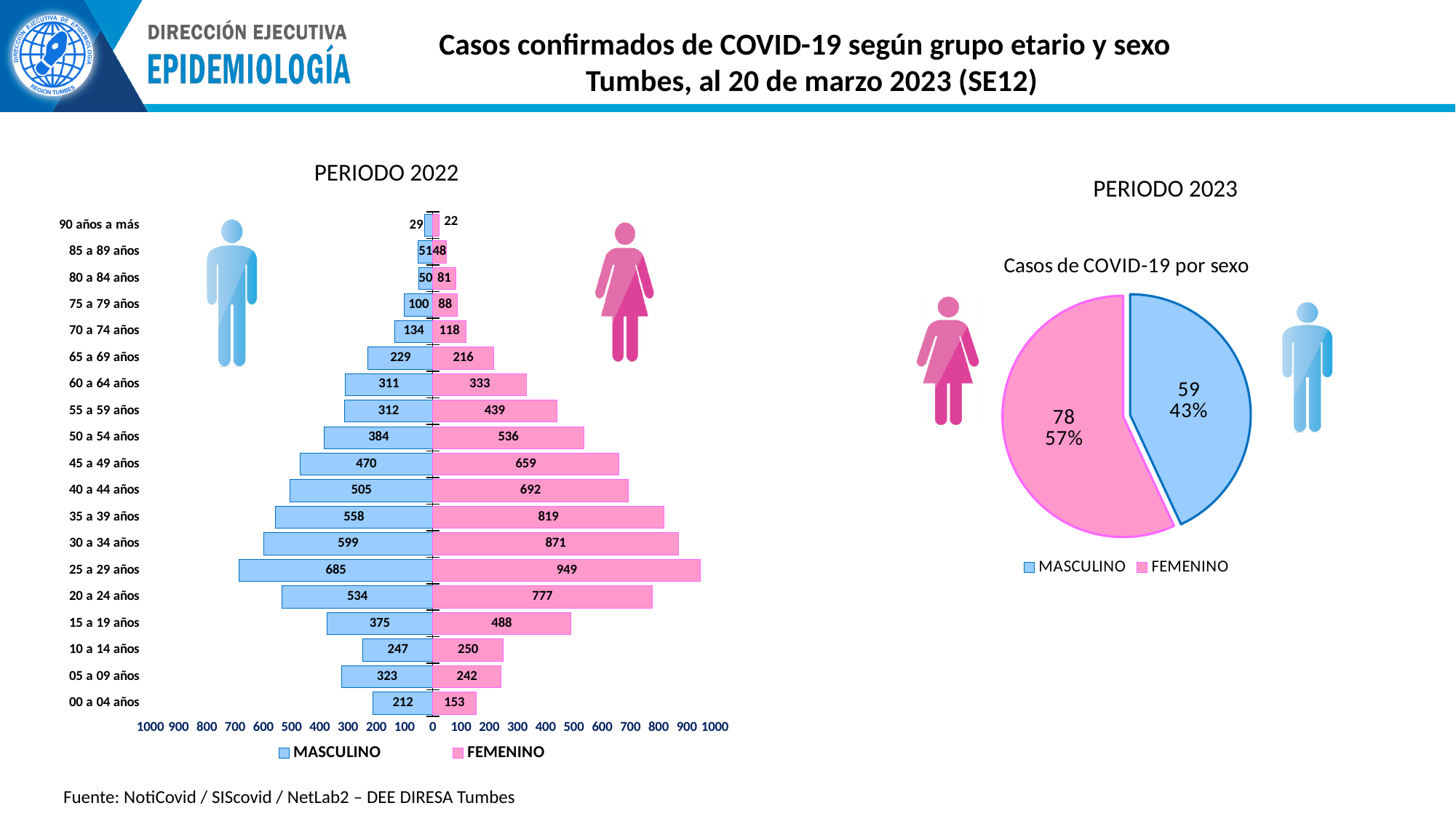
In the PERIODO 2023 pie chart, how many MASCULINO cases are shown? 59 How many age groups are shown in the PERIODO 2022 chart? 19 In the PERIODO 2022 chart, what is the difference between FEMENINO and MASCULINO cases in the 35 a 39 años group? 261 In the PERIODO 2022 chart, how many MASCULINO cases are shown for the 30 a 34 años group? 599 In the PERIODO 2022 chart, which is larger for the 05 a 09 años group, MASCULINO or FEMENINO? MASCULINO How many series does the legend of the PERIODO 2022 chart list? 2 In the PERIODO 2022 chart, which age group has the lowest number of FEMENINO cases? 90 años a más In the PERIODO 2023 pie chart, what percentage of cases are FEMENINO? 57% What is the title of the pie chart on the right side of the slide? Casos de COVID-19 por sexo In the PERIODO 2022 chart, which age group has the highest number of MASCULINO cases? 25 a 29 años In the PERIODO 2022 chart, how many FEMENINO cases are shown for the 25 a 29 años group? 949 What kind of chart is the PERIODO 2022 chart? Bar chart